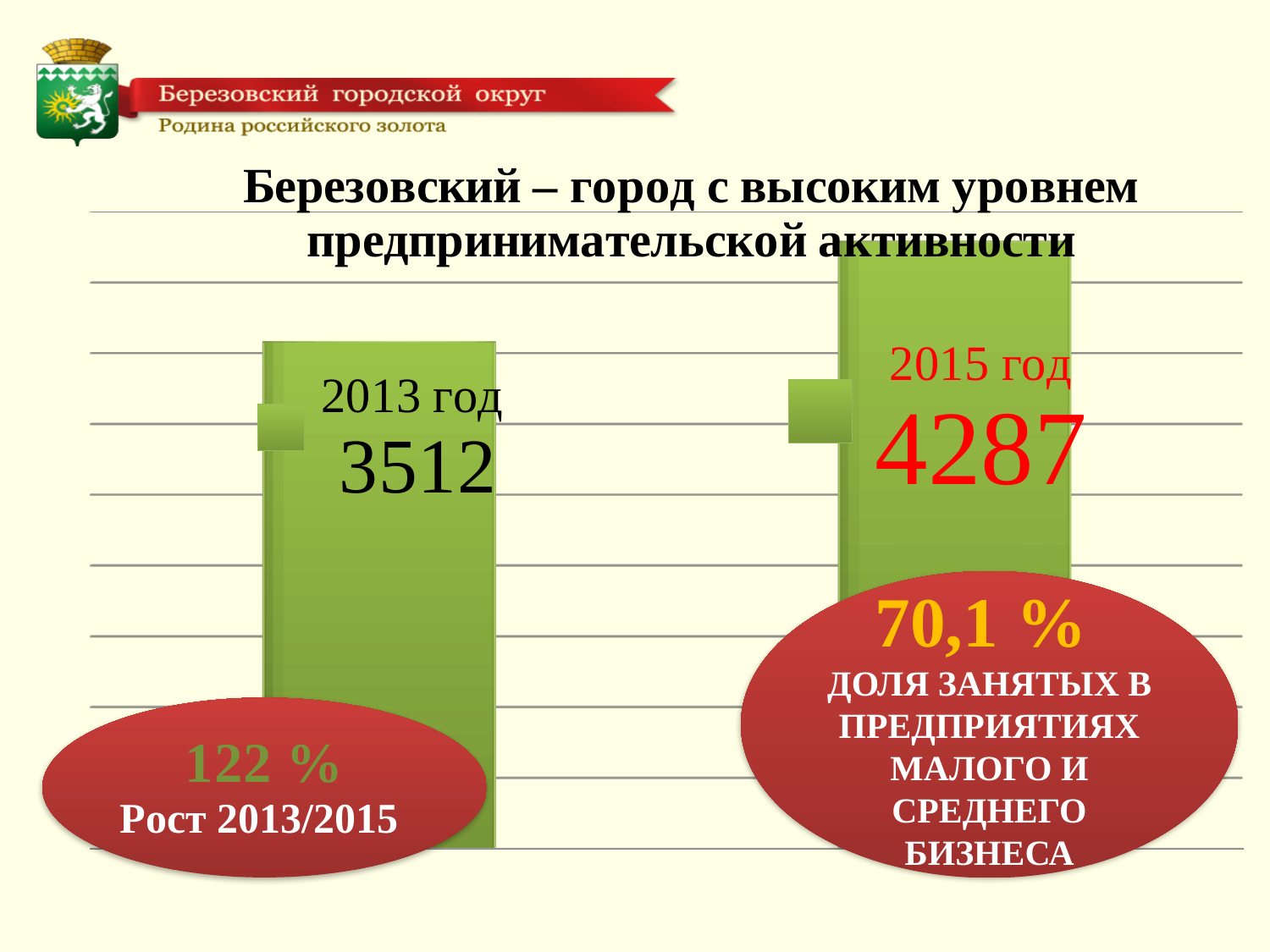
What is the value shown for 2013 год? 3512 What share of employed in small and medium business enterprises is shown in the red oval on the right? 70,1 % Which year has the lower bar? 2013 год What is the difference between the 2015 год value and the 2013 год value? 775 What is the value shown for 2015 год? 4287 Do the values rise or fall from 2013 год to 2015 год? rise Is the value for 2013 год larger or smaller than the value for 2015 год? smaller What growth percentage for 2013/2015 is shown in the red oval at the bottom left? 122 % What kind of chart is shown on the slide? bar chart How many bars are plotted in the chart? 2 Which year has the higher bar? 2015 год